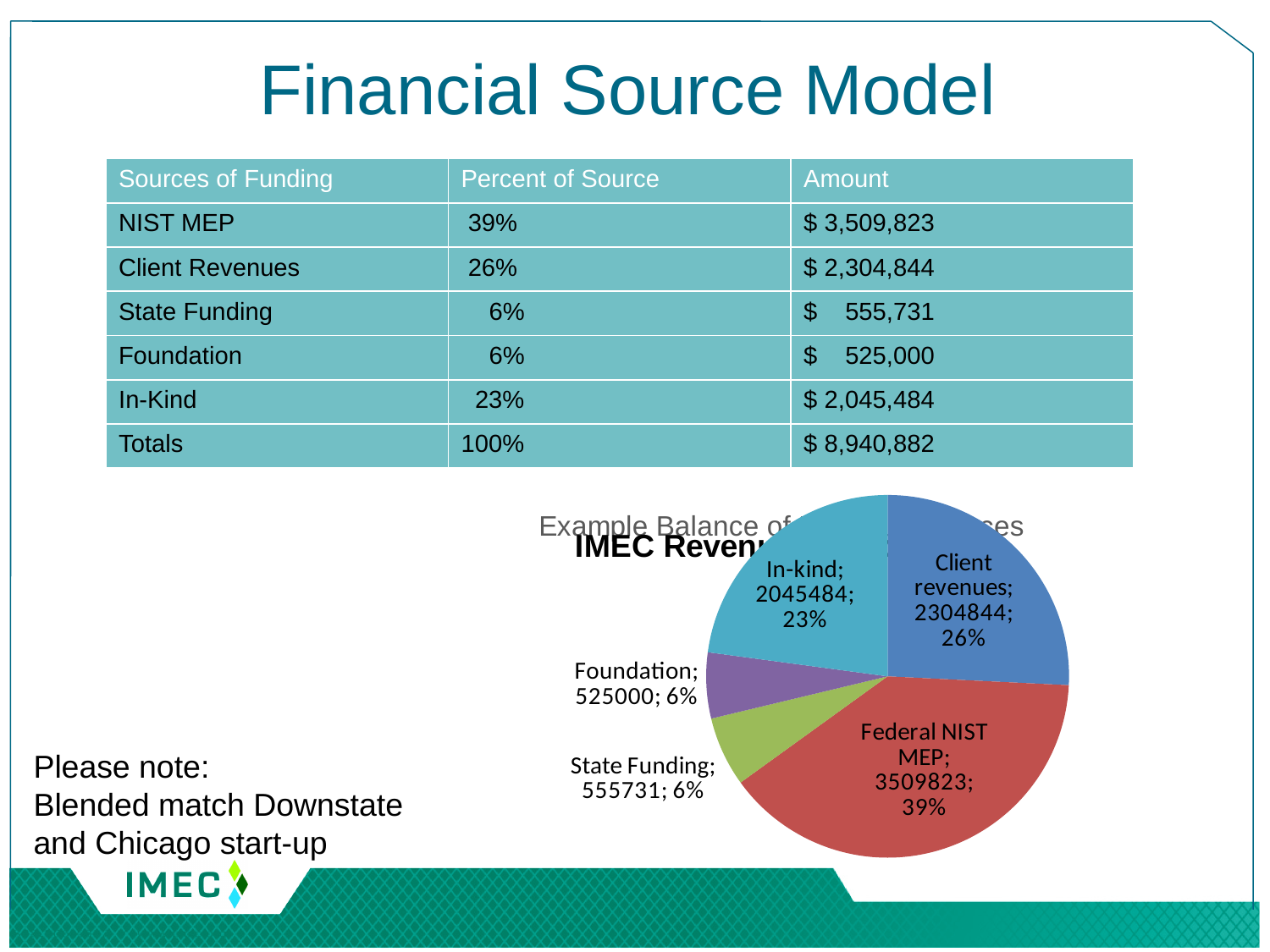
What value is shown for the In-kind slice of the pie chart? 2045484 What percentage share does the Client revenues slice have in the pie chart? 26% What is the difference between the State Funding value and the Foundation value in the pie chart? 30731 How many slices does the pie chart have? 5 What is the difference between the Federal NIST MEP value and the Client revenues value in the pie chart? 1204979 What kind of chart is shown on the slide? pie chart In the pie chart, which is larger, Client revenues or In-kind? Client revenues What value is shown for the State Funding slice of the pie chart? 555731 What percentage share does the Foundation slice have in the pie chart? 6% What value is shown for the Federal NIST MEP slice of the pie chart? 3509823 Which slice of the pie chart is the largest? Federal NIST MEP Which slice of the pie chart is the smallest? Foundation